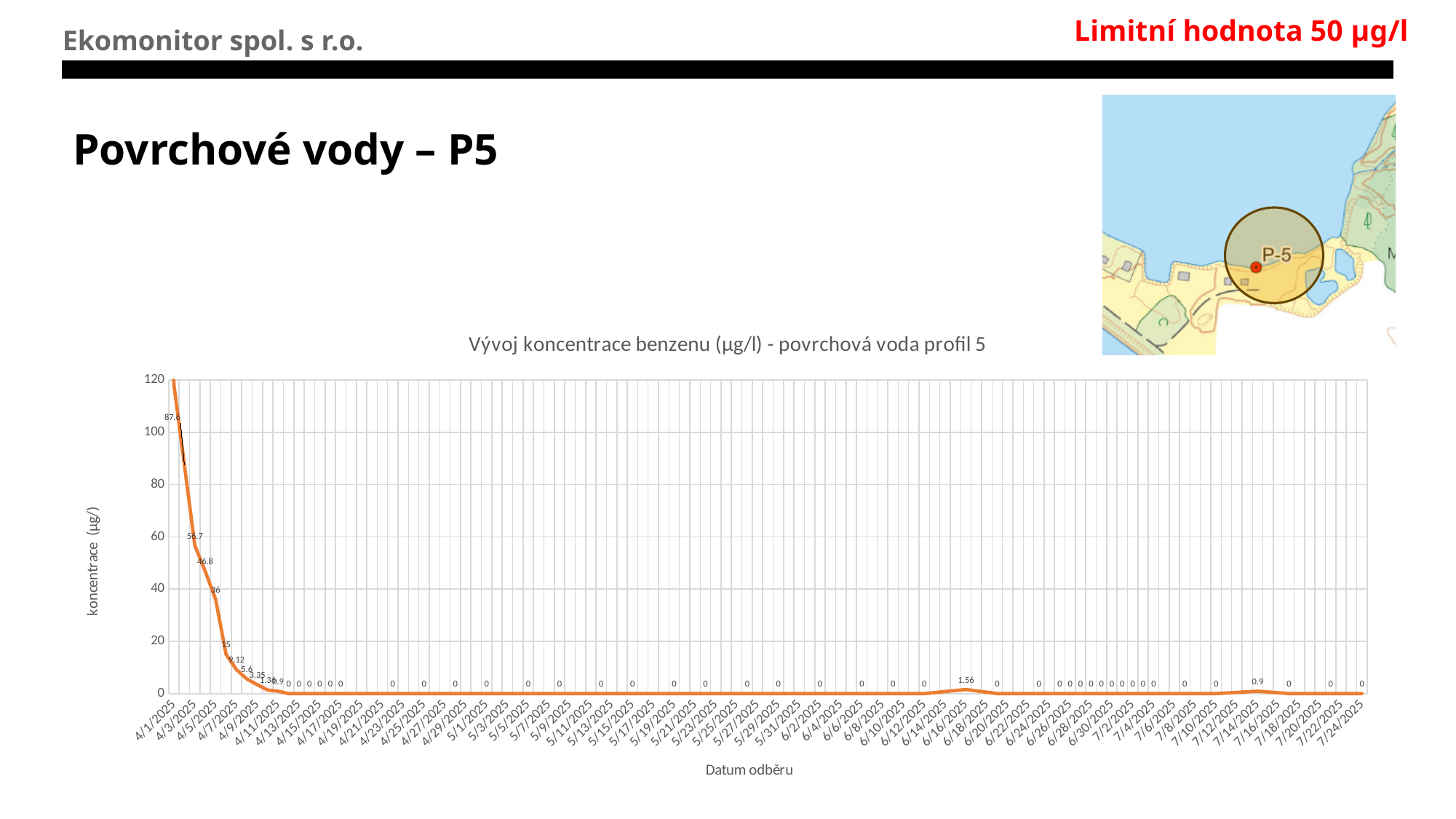
What is the highest value printed as a data label on the chart? 87.6 Is the value for 4/5/2025 greater or less than 60? less Is the value for 4/1/2025 greater or less than 100? greater What is the value for 5/1/2025? 0 What is the label of the vertical axis of the chart? koncentrace (µg/l) What kind of chart is shown on the slide? line chart What is the highest tick value shown on the vertical axis? 120 Do the benzene concentration values rise or fall along the x axis from 4/1/2025 onward? fall What is the lowest value shown on the chart? 0 What is the value for 7/24/2025? 0 What is the title of the chart? Vývoj koncentrace benzenu (µg/l) - povrchová voda profil 5